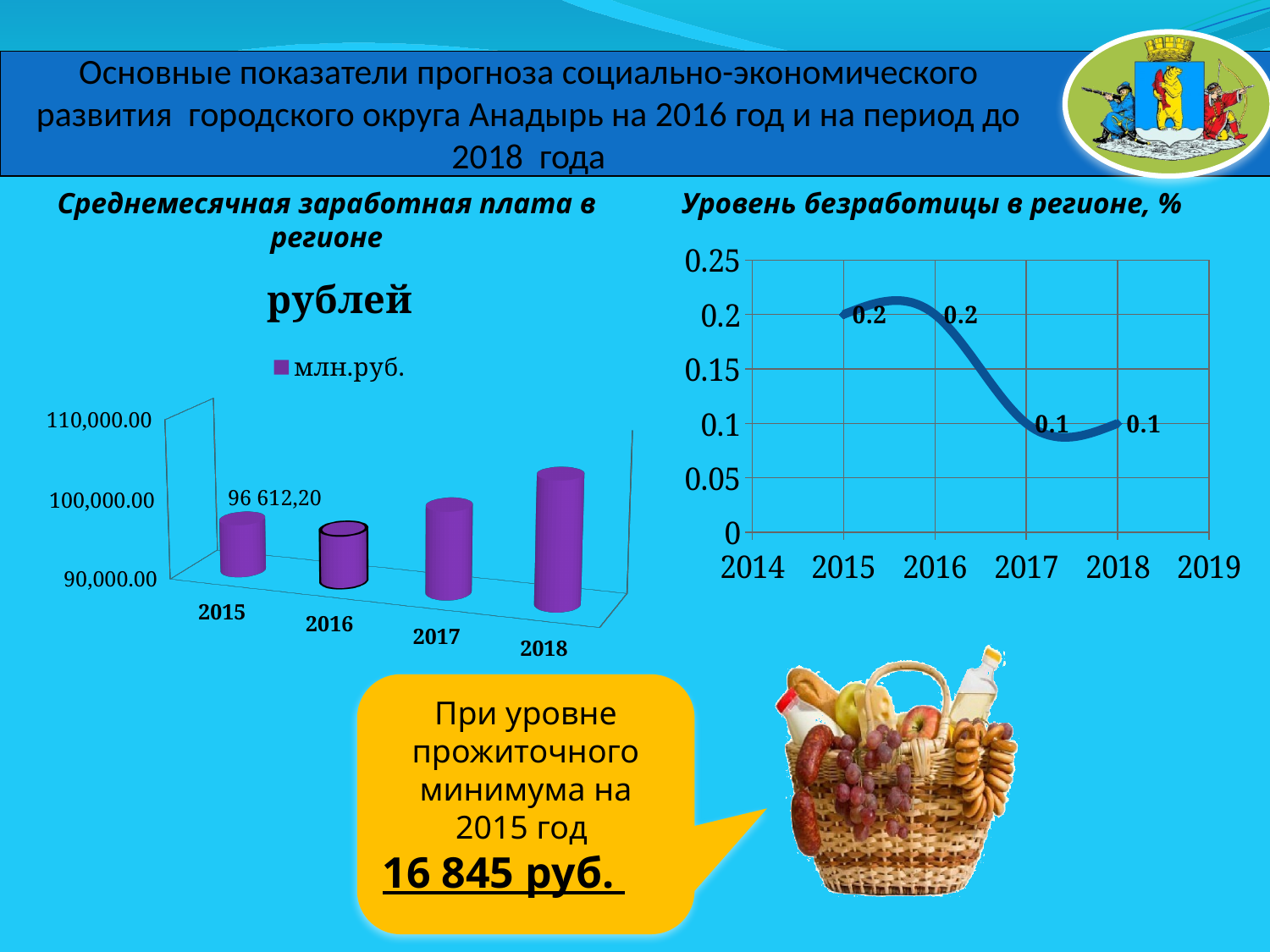
In the right chart 'Уровень безработицы в регионе, %', what is the difference between the values for 2016 and 2017? 0.1 What type of chart is the right chart titled 'Уровень безработицы в регионе, %'? line chart In the right chart 'Уровень безработицы в регионе, %', do the values rise or fall from 2015 to 2018? fall In the left chart 'Среднемесячная заработная плата в регионе', what is the value for 2015? 96 612,20 What type of chart is the left chart titled 'Среднемесячная заработная плата в регионе'? bar chart In the right chart 'Уровень безработицы в регионе, %', how many data points are labelled? 4 In the left chart 'Среднемесячная заработная плата в регионе', what is the legend entry? млн.руб. In the left chart 'Среднемесячная заработная плата в регионе', which year has the highest bar? 2018 In the right chart 'Уровень безработицы в регионе, %', what is the value for 2018? 0.1 In the right chart 'Уровень безработицы в регионе, %', what is the value for 2015? 0.2 In the left chart 'Среднемесячная заработная плата в регионе', how many years are shown on the x axis? 4